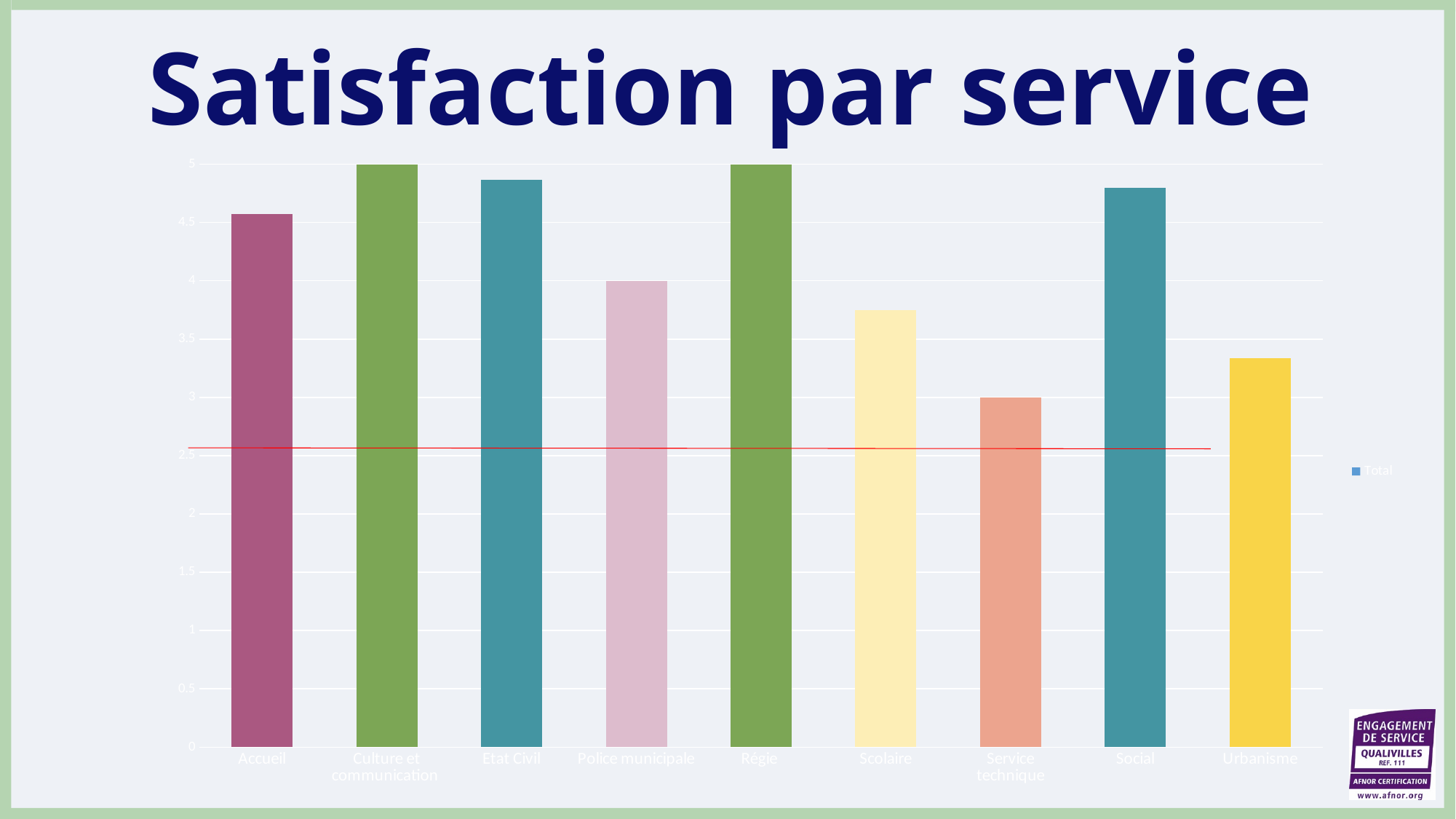
What is the value for Régie? 5 Is the value for Social greater or less than 4.5? greater What is the title of the chart? Satisfaction par service What kind of chart is shown on the slide? bar chart Which is larger, the value for Scolaire or the value for Urbanisme? Scolaire What is the value for Police municipale? 4 How many series does the legend list? 1 Which service has the lowest satisfaction value? Service technique What is the value for Service technique? 3 What is the difference between the values for Culture et communication and Police municipale? 1 How many services (categories) are shown on the x axis? 9 Is the value for Scolaire greater or less than 4? less